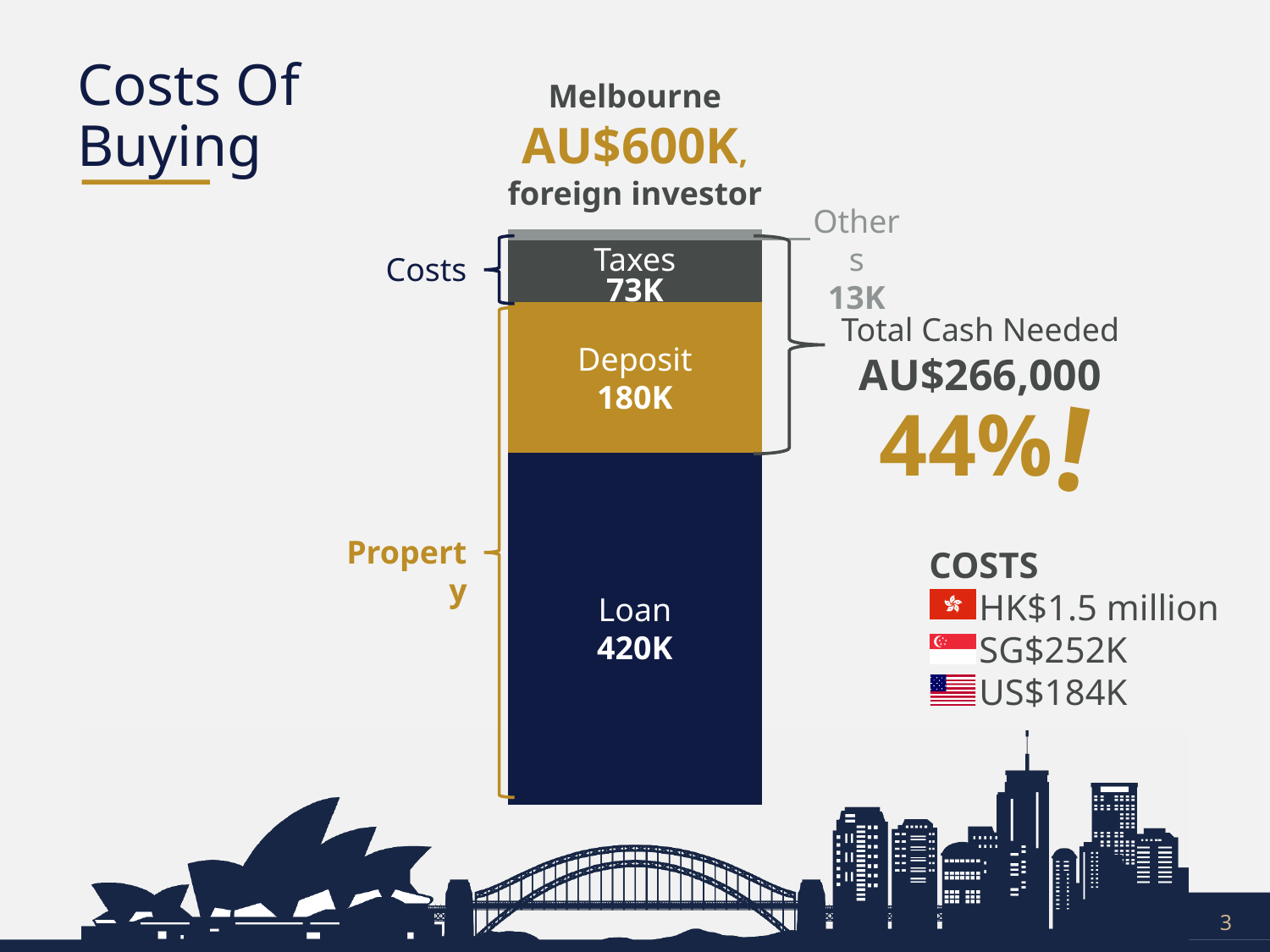
What is the total of the Loan and Deposit segments, labelled as Property? 600K What is the value of the Others segment in the stacked bar? 13K What is the value of the Taxes segment in the stacked bar? 73K What kind of chart is shown on the slide? Stacked bar chart How many segments make up the stacked bar? 4 Which is larger, the Deposit segment or the Taxes segment? Deposit Which segment of the stacked bar is the smallest? Others Which segment of the stacked bar is the largest? Loan What is the difference between the Taxes and Others segments? 60K What is the value of the Loan segment in the stacked bar? 420K What is the value of the Deposit segment in the stacked bar? 180K What is the difference between the Loan and Deposit segments? 240K